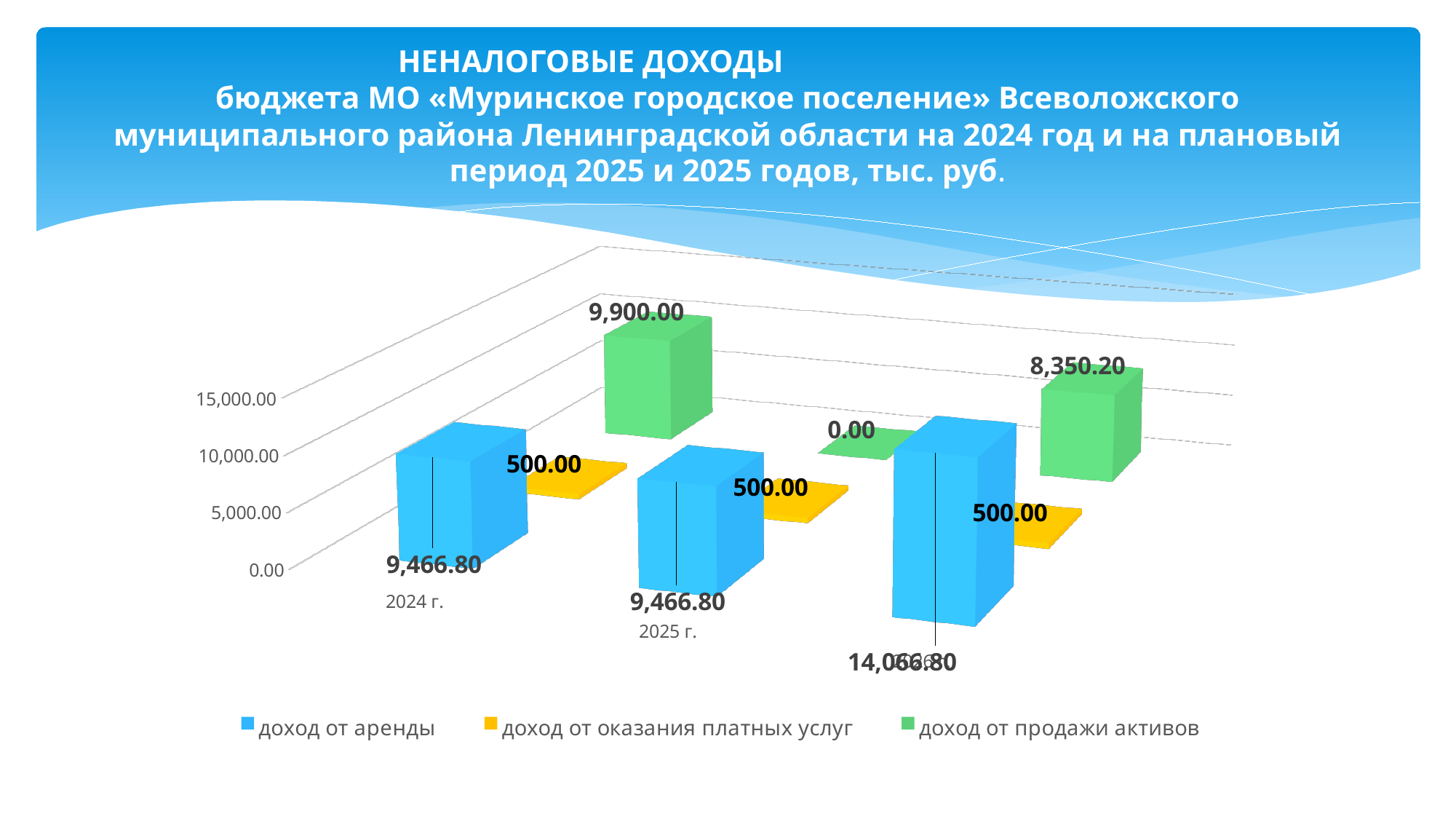
Which series has the highest value for 2024 г.? доход от продажи активов How many series does the legend list? 3 Is the value of «доход от аренды» for 2024 г. greater or less than 10,000.00? less What kind of chart is shown on the slide? bar chart What is the value of «доход от продажи активов» for 2025 г.? 0.00 What is the value of «доход от оказания платных услуг» for 2025 г.? 500.00 Which series has the lowest value for 2025 г.? доход от продажи активов Which is larger: «доход от продажи активов» for 2024 г. or for 2025 г.? 2024 г. What colour represents «доход от аренды» in the legend? blue What is the value of «доход от аренды» for 2024 г.? 9,466.80 What is the value of «доход от продажи активов» for 2024 г.? 9,900.00 For 2024 г., what is the difference between «доход от продажи активов» and «доход от аренды»? 433.20